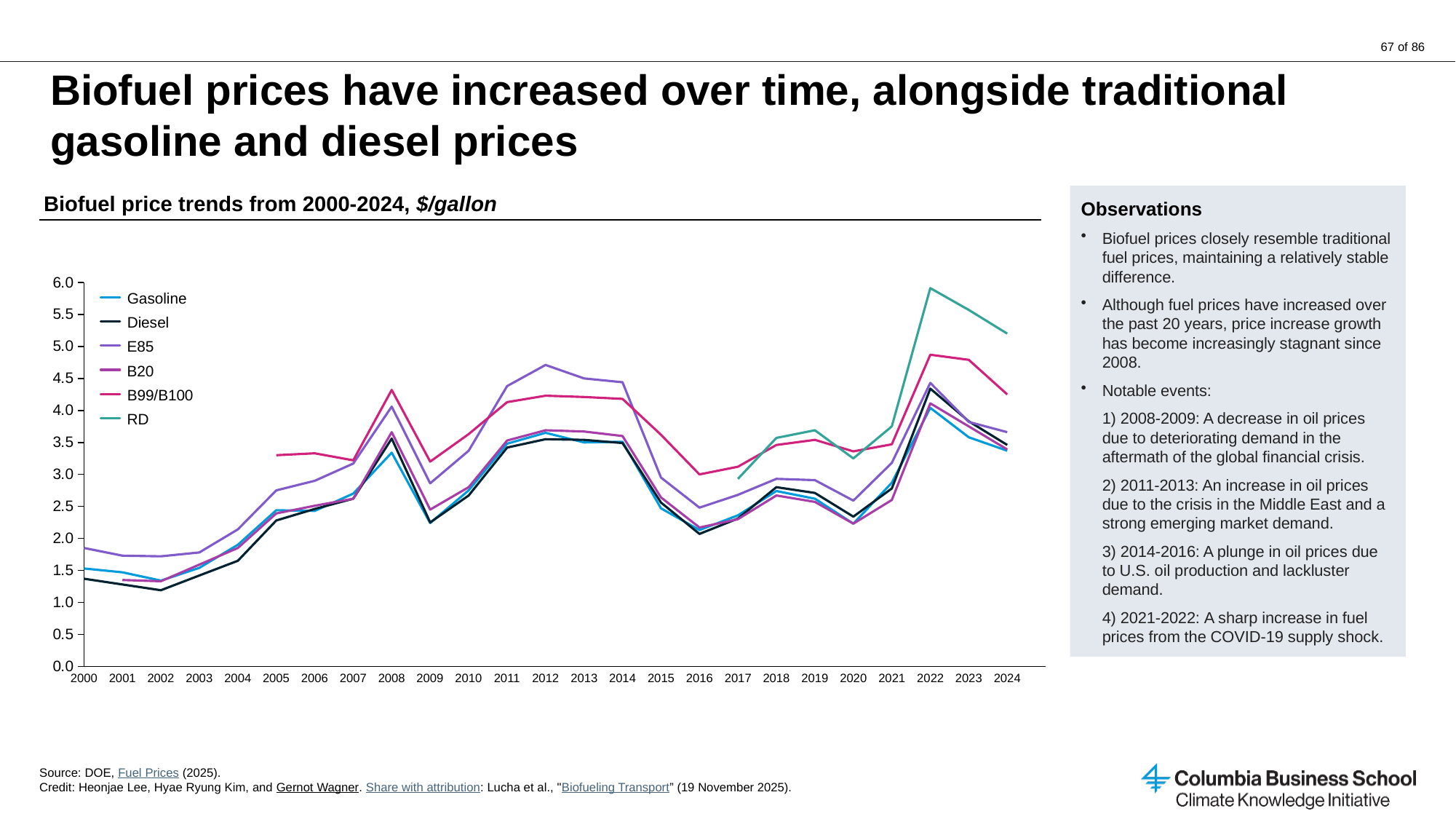
Is the value for RD in 2022 greater or less than 5.5? greater Which series has the highest value in 2022? RD How many years are plotted along the x axis? 25 Is the value for Diesel in 2002 greater or less than 1.5? less Does the RD series rise or fall from 2022 to 2024? fall How many series does the legend list? 6 Is the value for B99/B100 in 2008 greater or less than 4.0? greater What is the title of the chart? Biofuel price trends from 2000-2024, $/gallon In 2016, which is higher: Diesel or B99/B100? B99/B100 Does the Gasoline series rise or fall from 2000 to 2008? rise What kind of chart is shown on the slide? line chart